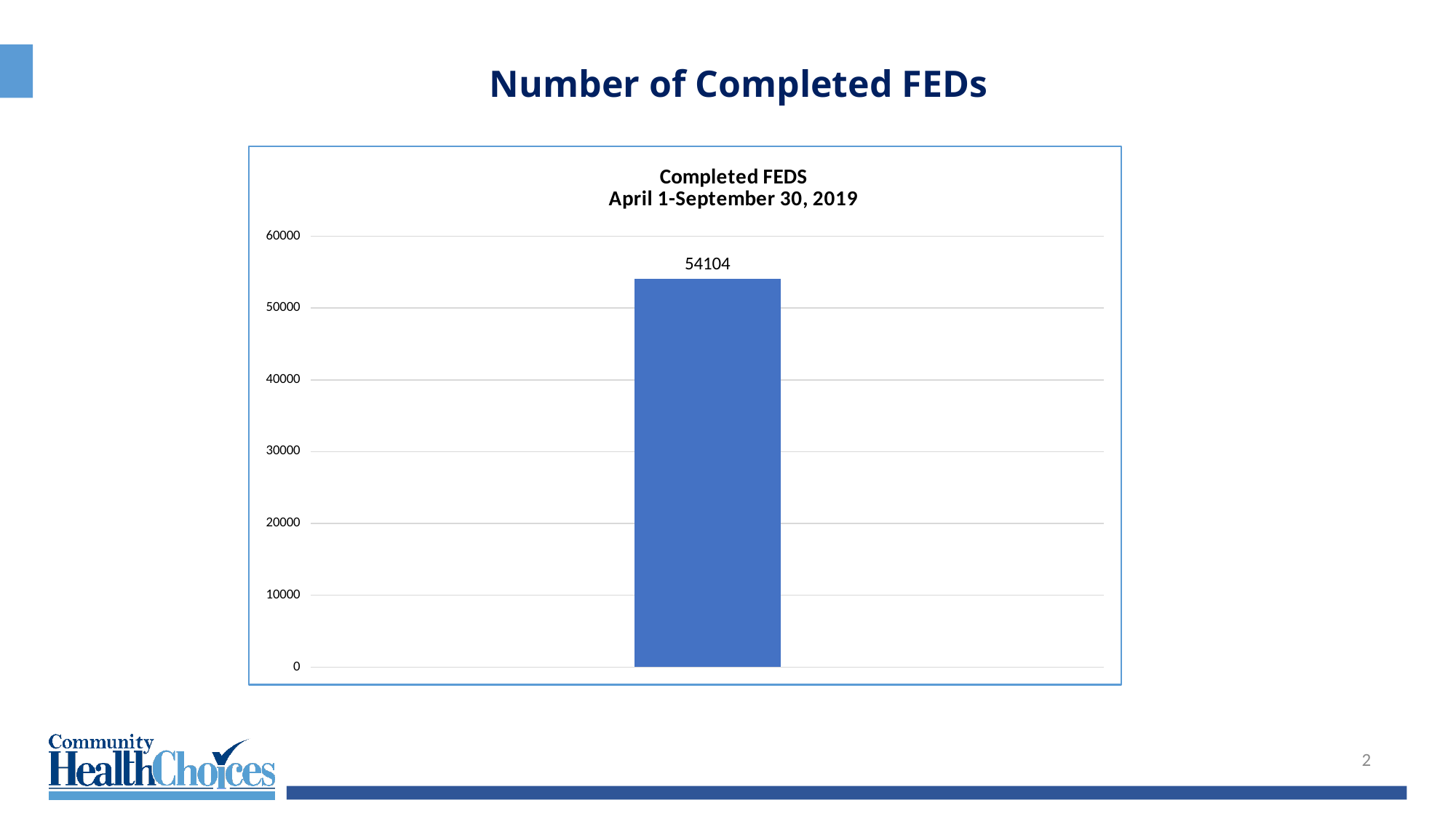
How many bars are plotted in the chart? 1 What is the title of the chart? Completed FEDS April 1-September 30, 2019 What is the value shown for completed FEDs from April 1 to September 30, 2019? 54104 What kind of chart is shown on the slide? bar chart Is the value of the bar greater or less than 60000? less Is the value of the bar greater or less than 50000? greater What is the highest value shown on the vertical axis? 60000